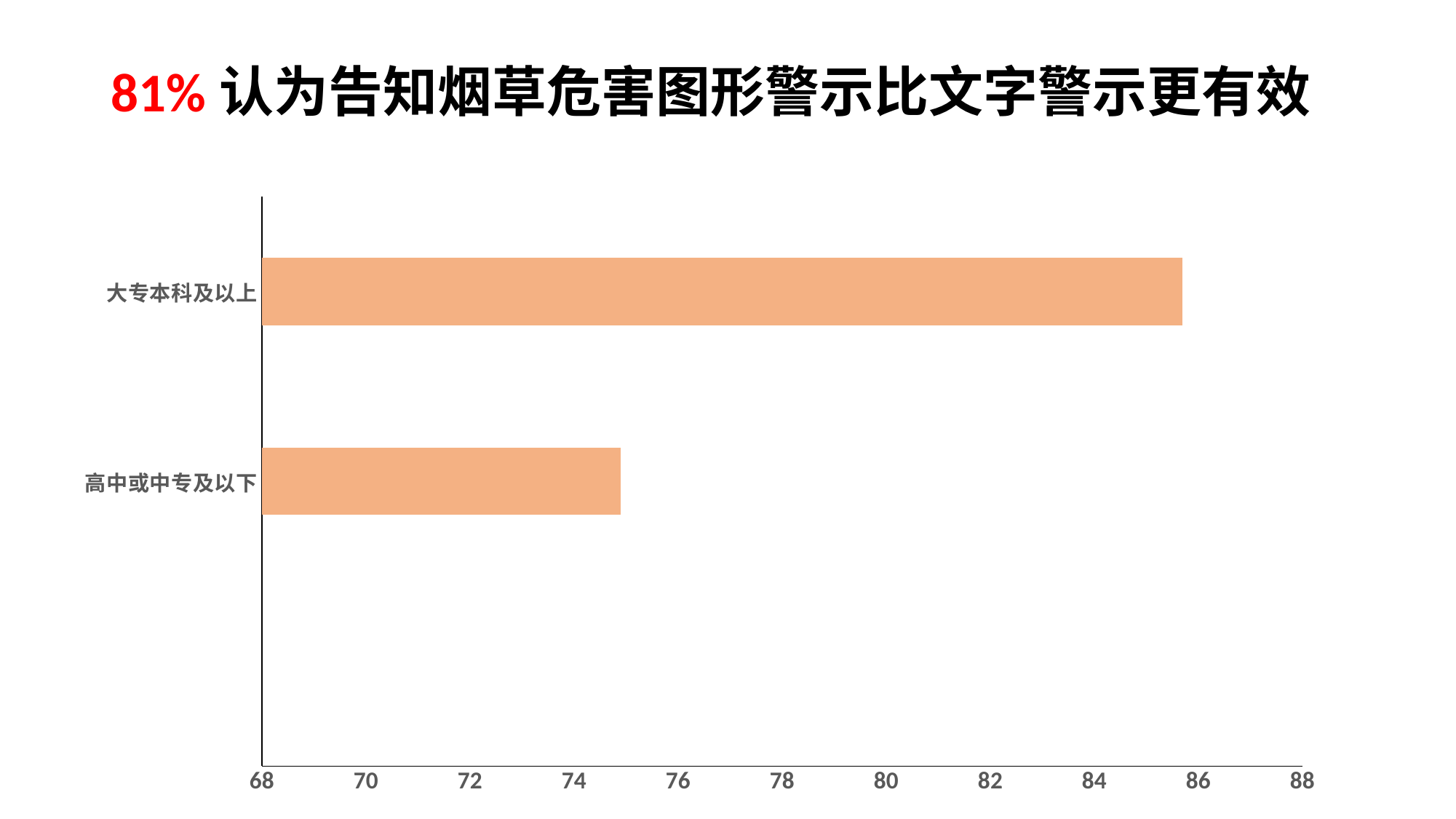
What is the highest value shown on the horizontal axis? 88 Which is larger, the value for 大专本科及以上 or the value for 高中或中专及以下? 大专本科及以上 Is the value for 高中或中专及以下 greater or less than 74? greater Is the value for 大专本科及以上 greater or less than 84? greater How many categories are plotted in the chart? 2 What kind of chart is shown on the slide? bar chart Which category has the lowest value? 高中或中专及以下 What percentage is highlighted in red in the slide title? 81% Is the value for 高中或中专及以下 greater or less than 76? less Which category has the highest value? 大专本科及以上